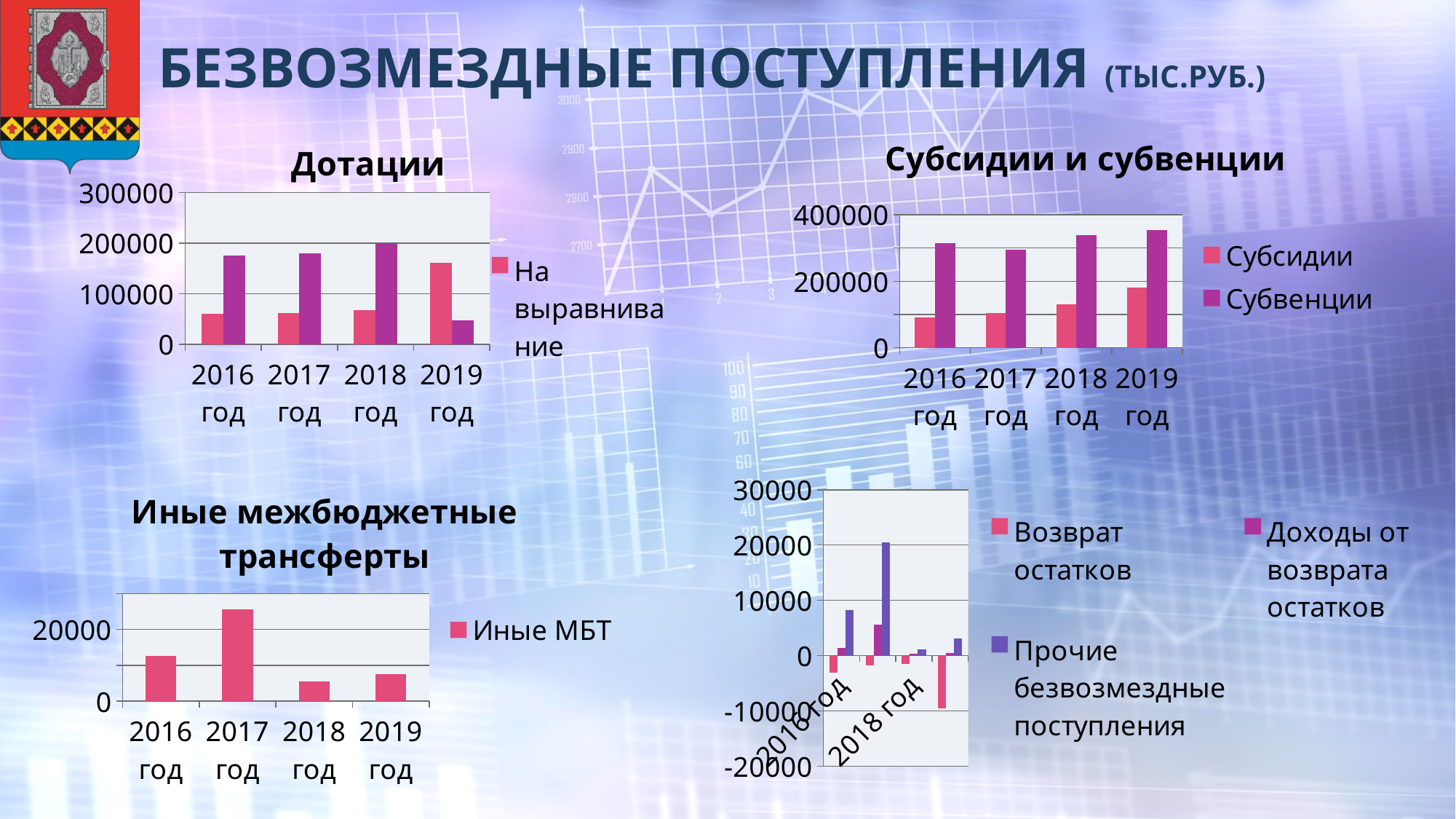
How many series does the legend of the bottom-right chart list? 3 In the "Субсидии и субвенции" chart, which year has the highest value for Субсидии? 2019 год In the "Субсидии и субвенции" chart, is the value for Субвенции in 2019 год greater or less than 200000? greater In the "Иные межбюджетные трансферты" chart, is the value for 2017 год greater or less than 20000? greater In the "Субсидии и субвенции" chart, do the Субсидии values rise or fall from 2016 год to 2019 год? rise In the "Иные межбюджетные трансферты" chart, which year has the highest value? 2017 год In the "Дотации" chart, is the value for the "На выравнивание" series in 2019 год greater or less than 100000? greater How many years are shown on the x axis of the "Иные межбюджетные трансферты" chart? 4 In the "Иные межбюджетные трансферты" chart, which year has the lowest value? 2018 год In the "Субсидии и субвенции" chart, how many series does the legend list? 2 What kind of chart is the "Дотации" chart? bar chart